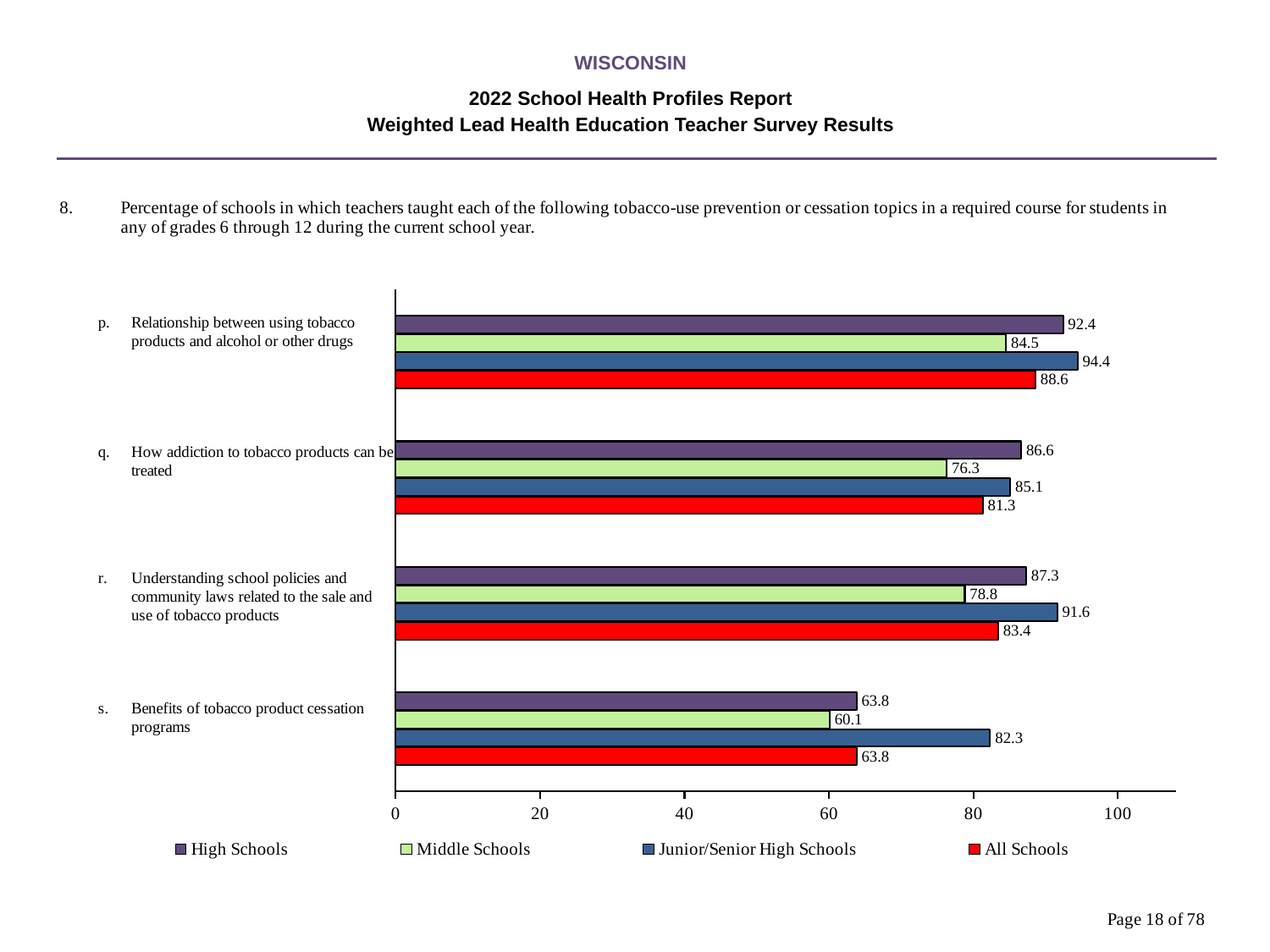
What is the value for Junior/Senior High Schools for topic p, relationship between using tobacco products and alcohol or other drugs? 94.4 What kind of chart is shown on the slide? Bar chart What is the difference between the Junior/Senior High Schools and Middle Schools values for topic s, benefits of tobacco product cessation programs? 22.2 Which topic has the highest High Schools value? p. Relationship between using tobacco products and alcohol or other drugs What is the All Schools value for topic q, how addiction to tobacco products can be treated? 81.3 How many series does the legend list? 4 Which topic has the lowest Middle Schools value? s. Benefits of tobacco product cessation programs For topic r, understanding school policies and community laws, which is larger: the High Schools value or the Middle Schools value? High Schools Which colour represents All Schools in the legend? Red What is the value for Middle Schools for topic s, benefits of tobacco product cessation programs? 60.1 How many topics are shown on the chart? 4 Is the All Schools value for topic s, benefits of tobacco product cessation programs, greater or less than 80? less